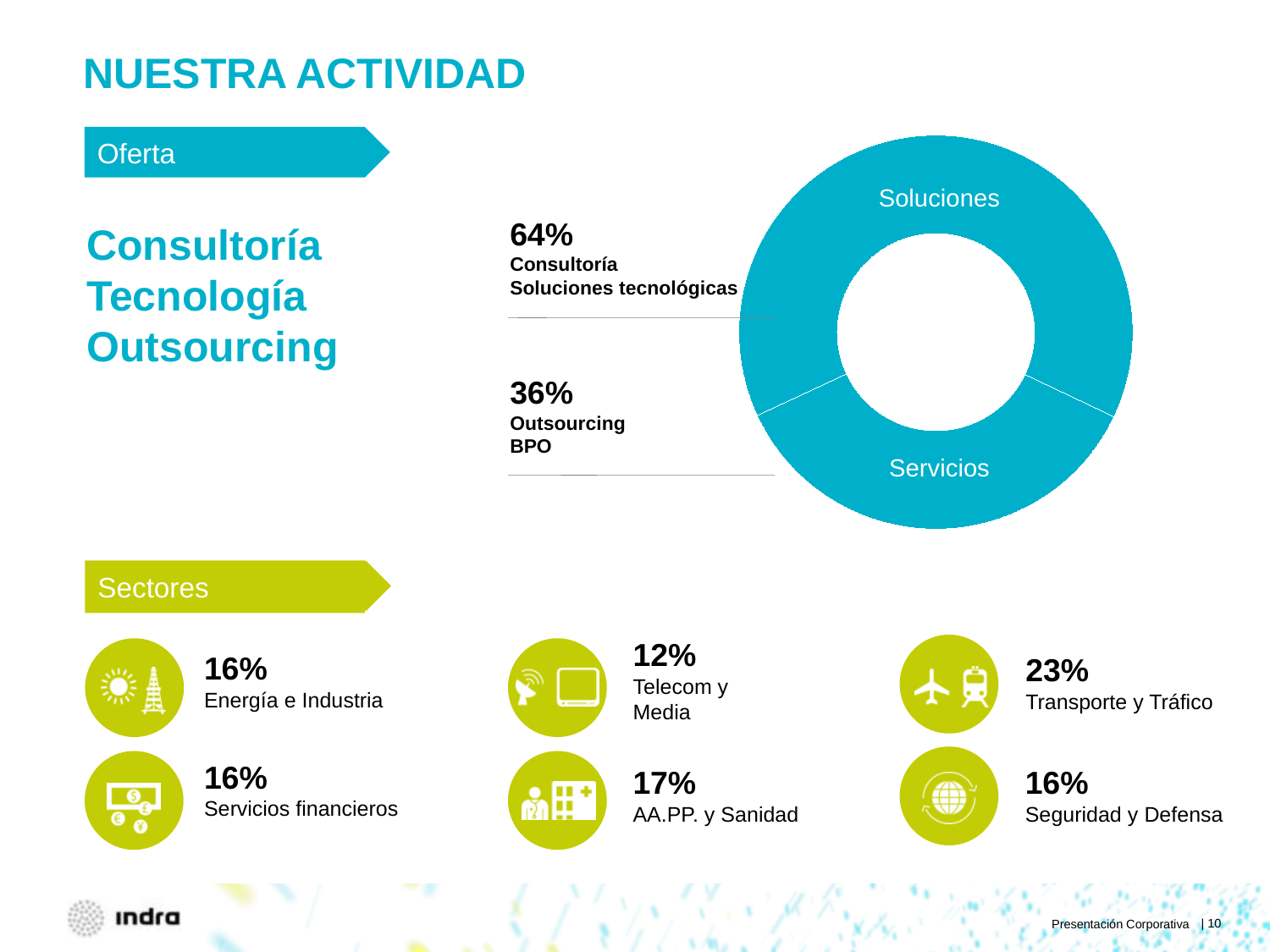
What share of the donut chart corresponds to Servicios? 36% What colour is the donut chart? turquoise blue Which segment of the donut chart is the smallest? Servicios How many segments does the donut chart have? 2 What is the difference in percentage points between the Soluciones and Servicios segments? 28 percentage points What kind of chart is shown on the slide? donut (pie) chart Which is larger in the donut chart, Soluciones or Servicios? Soluciones Is the Servicios segment greater or less than 50% of the donut chart? less What share of the donut chart corresponds to Soluciones? 64% Which two labels are printed inside the ring of the donut chart? Soluciones and Servicios Which segment of the donut chart is the largest? Soluciones